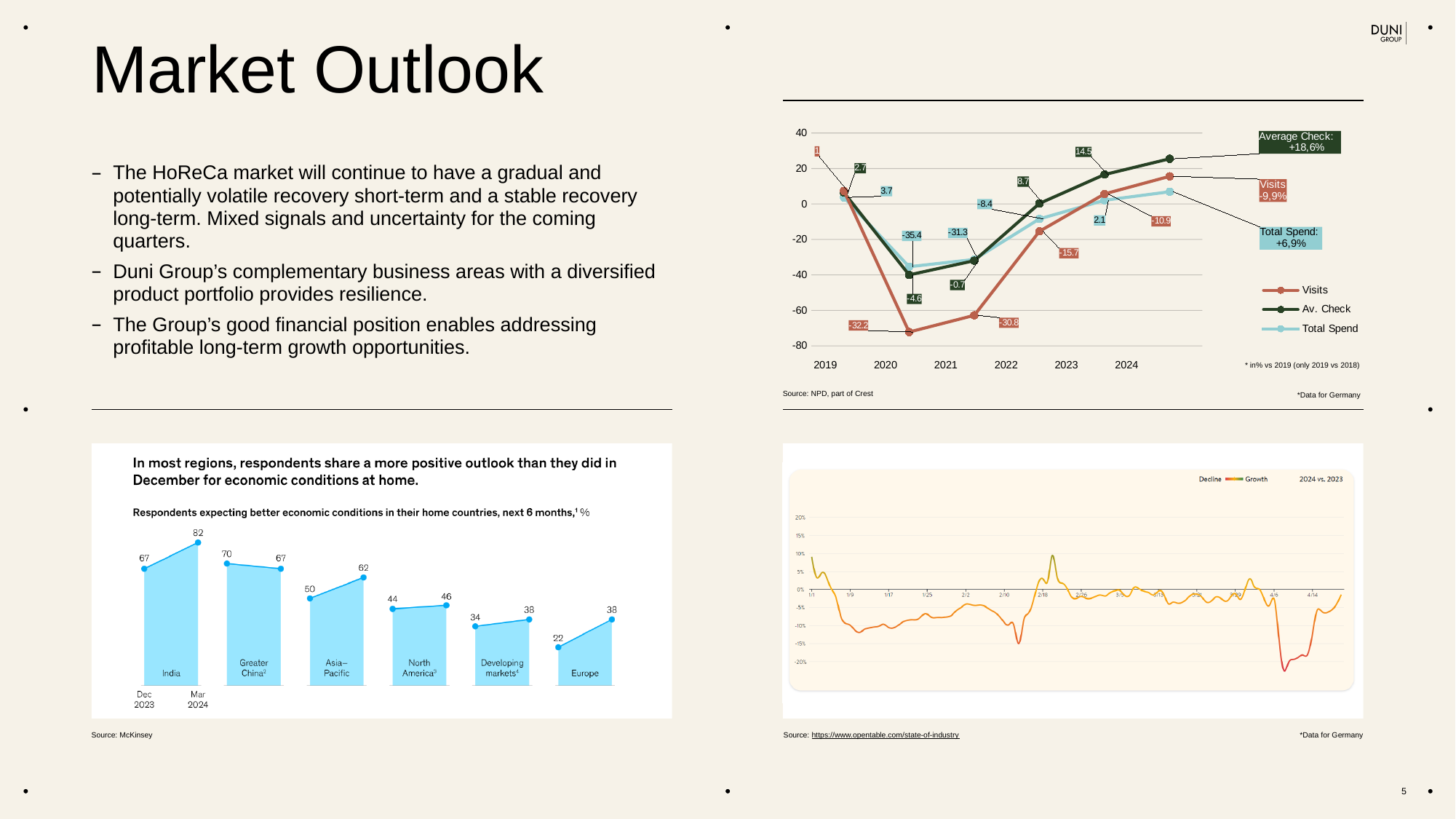
In the top-right chart, what is the Visits value shown in the callout for 2024? -9,9% In the bottom-left chart, which region has the highest Mar 2024 value? India In the bottom-left chart, for Greater China, which is larger: the Dec 2023 value or the Mar 2024 value? Dec 2023 How many series does the legend of the top-right chart list? 3 What kind of chart is the top-right chart? line chart In the bottom-left chart, by how many percentage points did India's value increase from Dec 2023 to Mar 2024? 15 In the bottom-left chart, what percentage of respondents in India expected better economic conditions in Mar 2024? 82 In the top-right chart, what is the Average Check value shown in the callout for 2024? +18,6% In the bottom-left chart, what was the Dec 2023 value for Europe? 22 In the bottom-left chart, which region has the lowest Dec 2023 value? Europe How many regions are shown in the bottom-left chart? 6